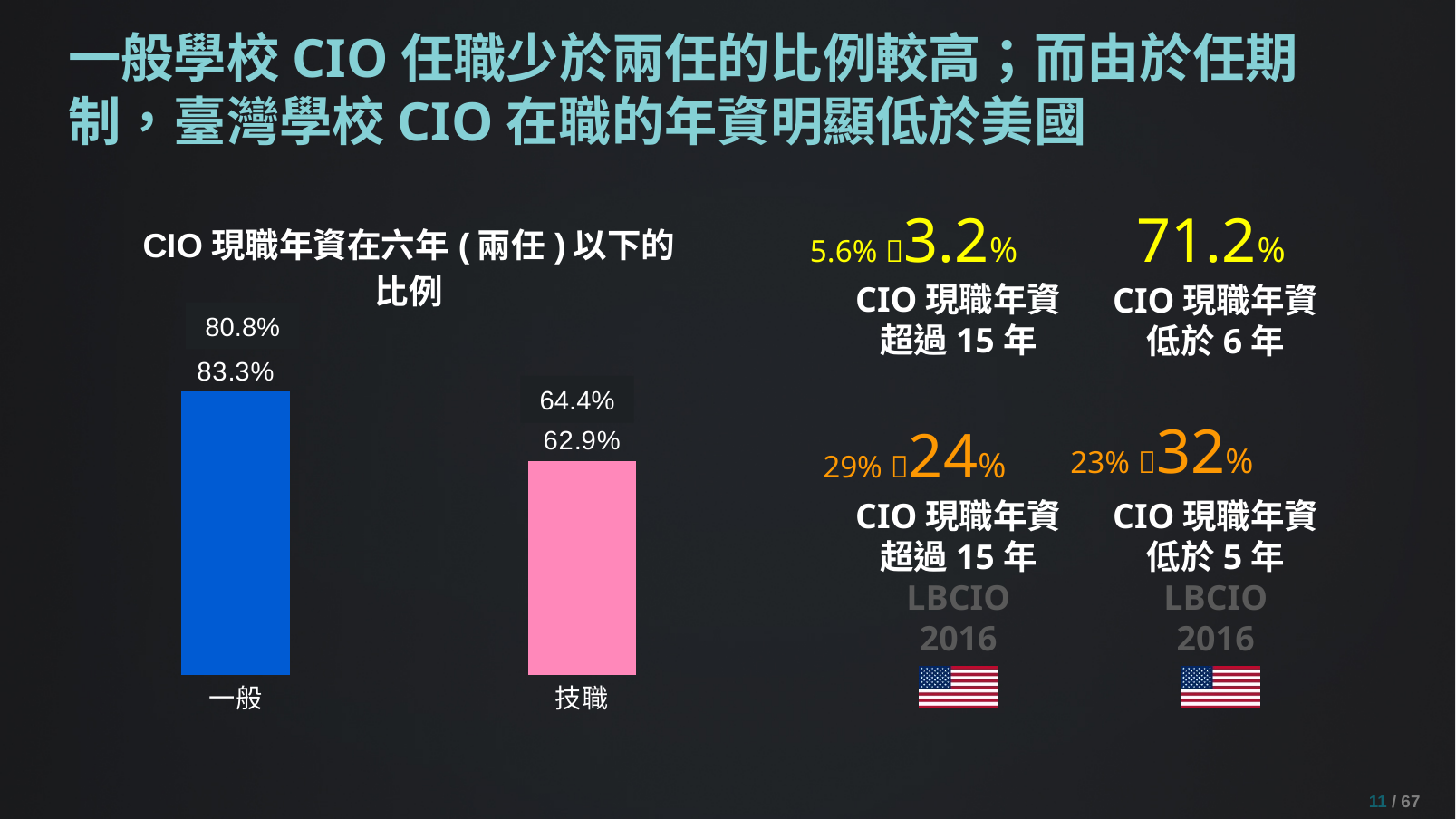
Which category has the taller bar in the chart, 一般 or 技職? 一般 What is the value printed directly above the 一般 bar (the lower of its two labels)? 83.3% What colour is the 技職 bar? pink What is the title of the bar chart? CIO 現職年資在六年 ( 兩任 ) 以下的比例 What two values are printed above the 一般 bar? 80.8% and 83.3% What is the value printed directly above the 技職 bar (the lower of its two labels)? 62.9% Which category has the lowest bar in the chart? 技職 What kind of chart is shown on the slide? bar chart What is the difference between the label directly above the 一般 bar (83.3%) and the label directly above the 技職 bar (62.9%)? 20.4% Which category has the highest bar in the chart? 一般 What two values are printed above the 技職 bar? 64.4% and 62.9% How many categories does the bar chart show? 2